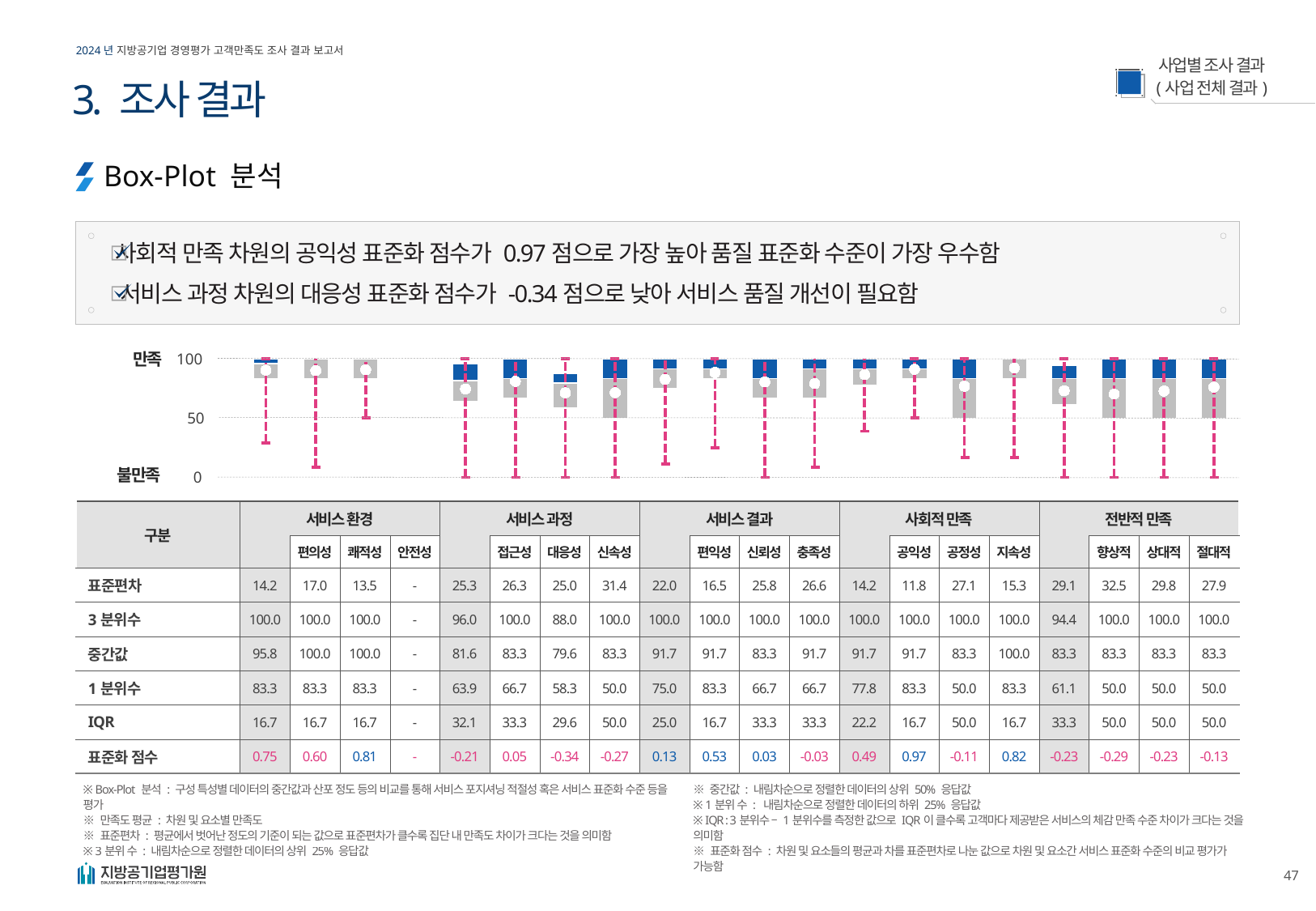
What is the difference between the 3 분위수 and the 1 분위수 for 접근성? 33.3 What is the 표준화 점수 for 지속성? 0.82 Which item has the highest 표준편차 (standard deviation)? 향상적 (32.5) What are the labels at the top and bottom of the chart's vertical axis? 만족 (100) and 불만족 (0) Which item has the highest 표준화 점수 (standardized score)? 공익성 (0.97) Is the 1 분위수 for 대응성 greater or less than 50? greater What kind of chart is shown on the slide? Box plot Which item has the lowest 표준화 점수 (standardized score)? 대응성 (-0.34) What is the 중간값 (median) for 대응성? 79.6 What is the IQR for 신속성? 50.0 Which has the larger 표준편차 (standard deviation), 향상적 or 편의성? 향상적 How many box plots are drawn in the chart? 19